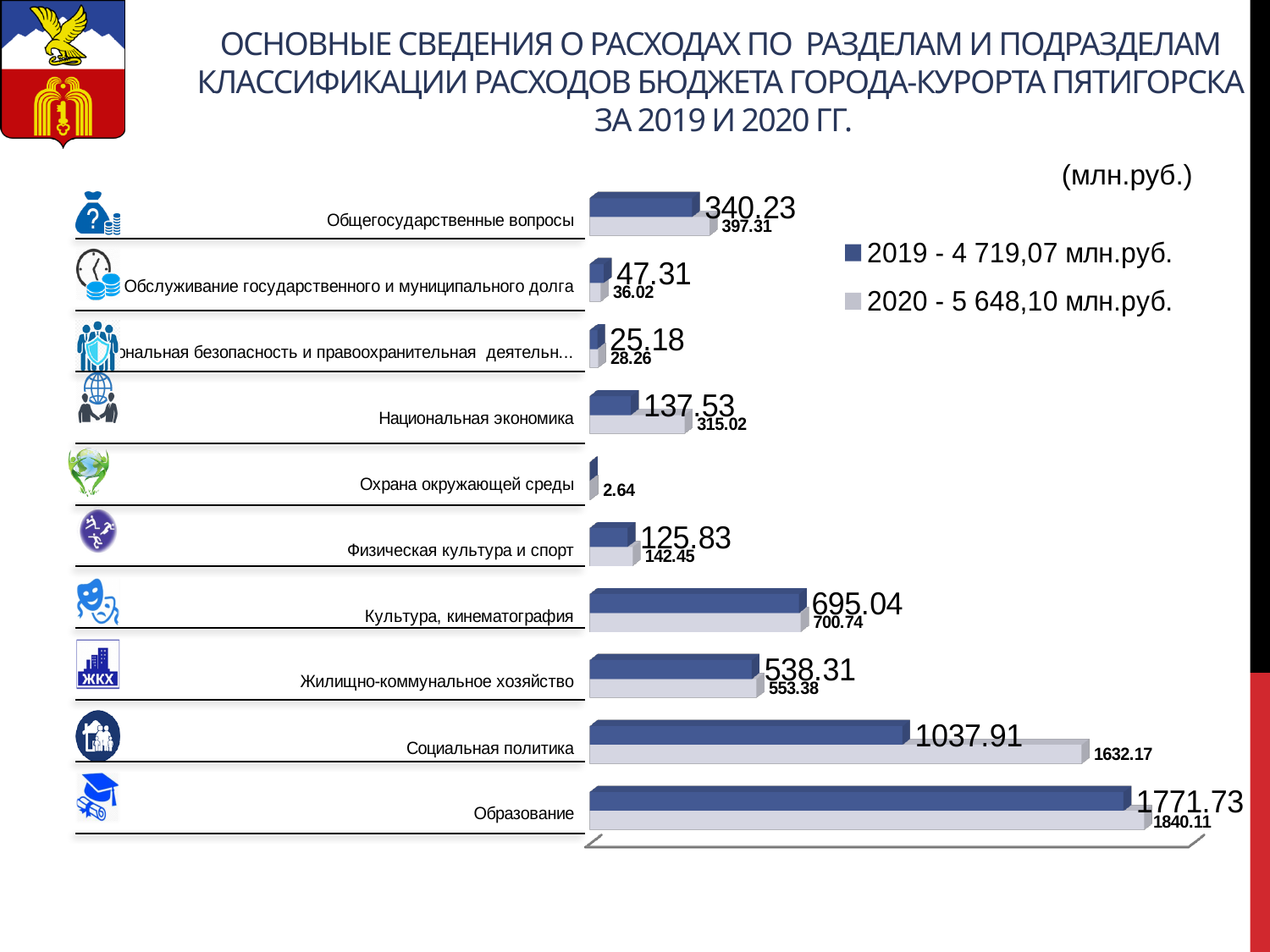
According to the legend, what is the total for 2020? 5 648,10 млн.руб. Which category has the lowest 2019 value among those with a printed 2019 label? Национальная безопасность и правоохранительная деятельн... What is the difference between the 2020 and 2019 values for Социальная политика? 594.26 How many categories are shown in the chart? 10 What type of chart is shown on the slide? bar chart Which category has the highest 2020 value? Образование How many series does the legend list? 2 What is the 2020 value for Социальная политика? 1632.17 Which is larger for Обслуживание государственного и муниципального долга: the 2019 value or the 2020 value? 2019 What is the 2020 value for Обслуживание государственного и муниципального долга? 36.02 What is the 2019 value for Образование? 1771.73 What is the 2019 value for Национальная экономика? 137.53